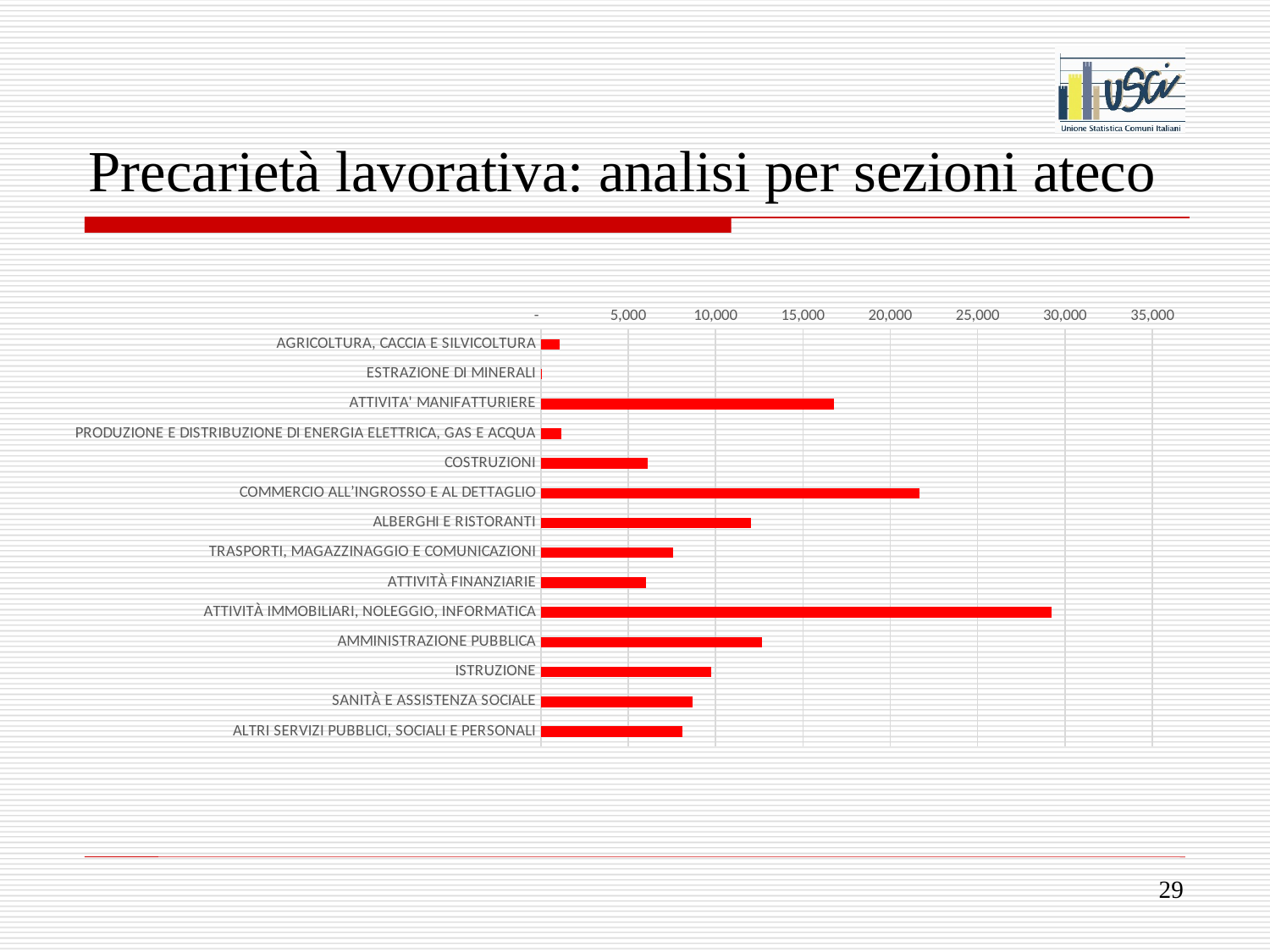
Which is larger, the value for ISTRUZIONE or the value for COSTRUZIONI? ISTRUZIONE What colour are the bars in the chart? red Which is larger, the value for COMMERCIO ALL'INGROSSO E AL DETTAGLIO or the value for ATTIVITA' MANIFATTURIERE? COMMERCIO ALL'INGROSSO E AL DETTAGLIO Is the value for AGRICOLTURA, CACCIA E SILVICOLTURA greater or less than 5,000? less Is the value for ATTIVITÀ IMMOBILIARI, NOLEGGIO, INFORMATICA greater or less than 25,000? greater Which category has the longest bar in the chart? ATTIVITÀ IMMOBILIARI, NOLEGGIO, INFORMATICA What is the title of the slide containing the chart? Precarietà lavorativa: analisi per sezioni ateco What kind of chart is shown on the slide? bar chart How many categories (ateco sections) are plotted in the chart? 14 Is the value for ATTIVITA' MANIFATTURIERE greater or less than 15,000? greater Which category has the shortest bar in the chart? ESTRAZIONE DI MINERALI